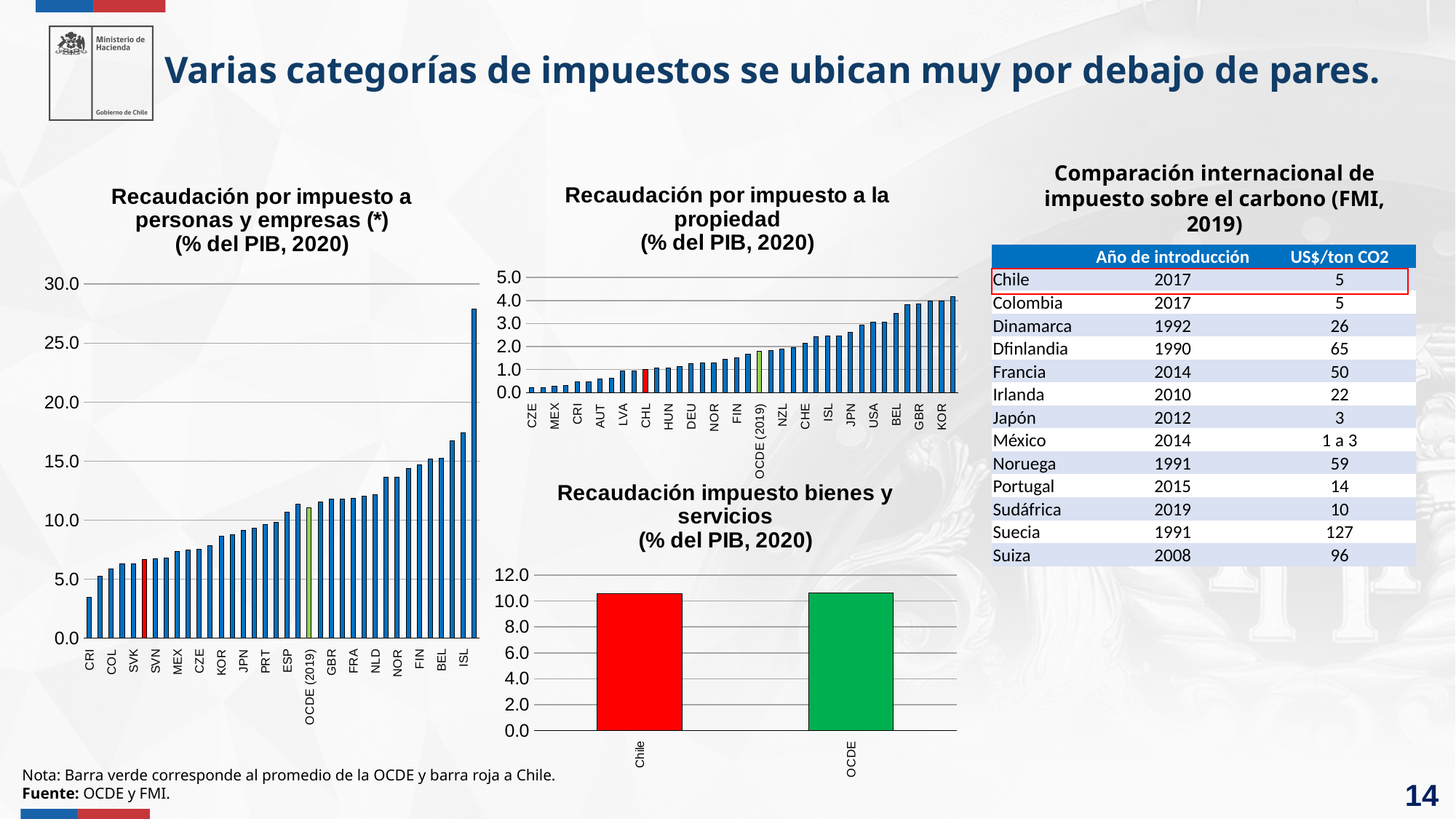
In the chart 'Recaudación impuesto bienes y servicios (% del PIB, 2020)', is the value for Chile greater or less than 8.0? greater In the chart 'Recaudación por impuesto a la propiedad (% del PIB, 2020)', which is larger, the value for KOR or the value for CHL? KOR In the chart 'Recaudación por impuesto a personas y empresas (*) (% del PIB, 2020)', is the value of the red bar (Chile) greater or less than 10.0? less In the chart 'Recaudación por impuesto a la propiedad (% del PIB, 2020)', which country has the lowest value? CZE What type of chart is 'Recaudación impuesto bienes y servicios (% del PIB, 2020)'? bar chart In the chart 'Recaudación por impuesto a personas y empresas (*) (% del PIB, 2020)', which country has the lowest value? CRI How many bars are in the chart 'Recaudación impuesto bienes y servicios (% del PIB, 2020)'? 2 In the chart 'Recaudación por impuesto a personas y empresas (*) (% del PIB, 2020)', is the value for ISL greater or less than 25.0? less In the chart 'Recaudación por impuesto a personas y empresas (*) (% del PIB, 2020)', do the values rise or fall from left to right? rise